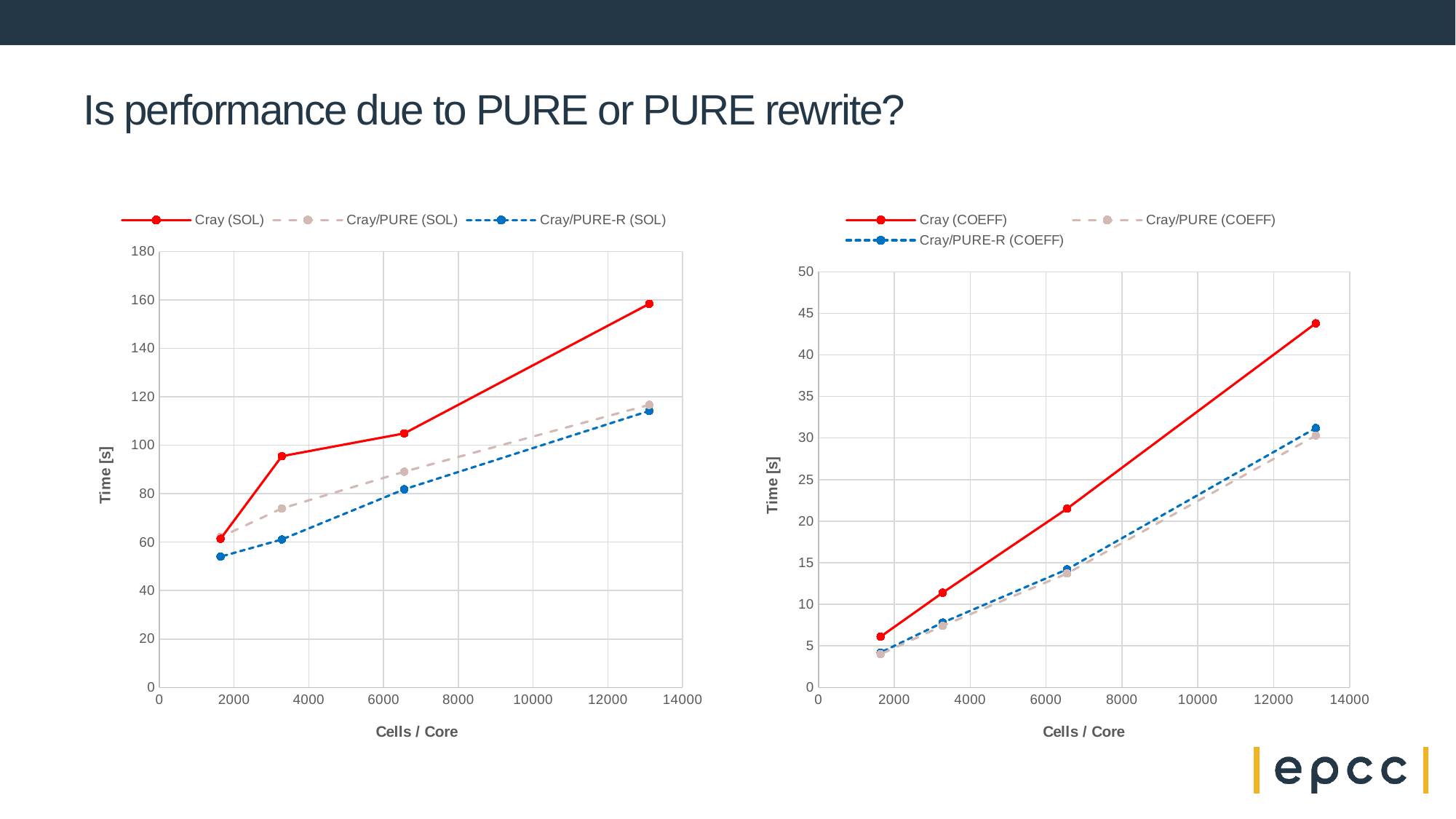
What is the x-axis label of the left chart (SOL)? Cells / Core How many series does the legend of the left chart (SOL) list? 3 In the left chart (SOL), is the value for Cray (SOL) at the highest Cells / Core point greater or less than 140? greater In the left chart (SOL), is the value for Cray/PURE-R (SOL) at the lowest Cells / Core point greater or less than 60? less What kind of chart is the left chart (SOL)? line chart In the left chart (SOL), how many data points does the Cray (SOL) series have? 4 In the right chart (COEFF), which series has the highest time at the largest Cells / Core value? Cray (COEFF) In the right chart (COEFF), do the values for Cray (COEFF) rise or fall as Cells / Core increases? rise In the right chart (COEFF), is the value for Cray (COEFF) at the highest Cells / Core point greater or less than 40? greater How many series does the legend of the right chart (COEFF) list? 3 In the left chart (SOL), at the highest Cells / Core point, which is larger: Cray (SOL) or Cray/PURE-R (SOL)? Cray (SOL)